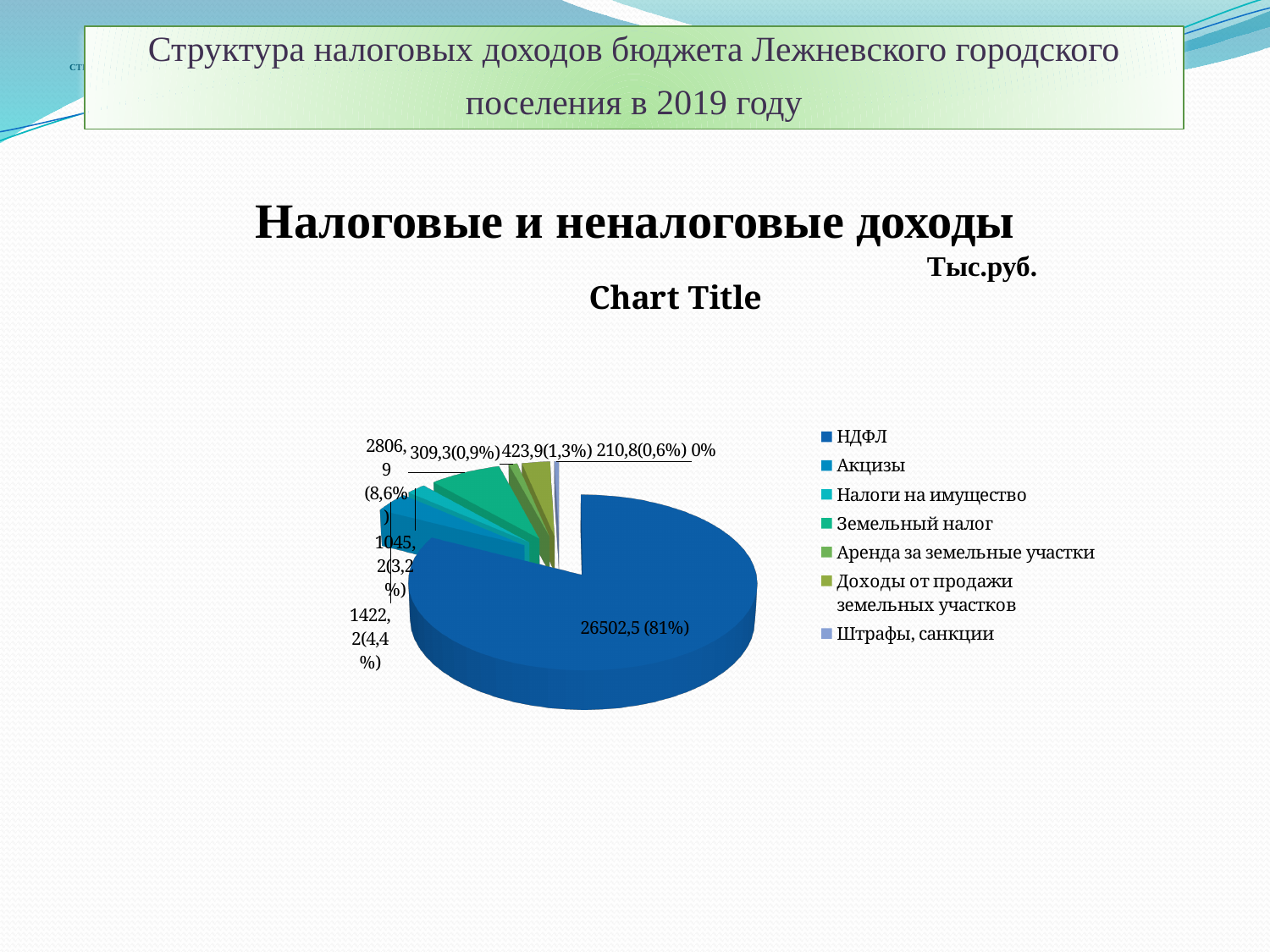
How many entries does the legend list? 7 What type of chart is shown on the slide? pie chart What value is labelled on the НДФЛ slice? 26502,5 (81%) In what units are the chart values given, according to the slide? Тыс.руб. What is the second-largest value labelled on the pie? 2806,9 (8,6%) Is the share of НДФЛ greater or less than 50%? greater What share of the pie does НДФЛ account for? 81% What title is printed directly above the pie chart? Chart Title What is the difference between the largest labelled value (26502,5) and the second-largest labelled value (2806,9)? 23695,6 Which is larger: the slice labelled 1422,2 or the slice labelled 1045,2? 1422,2 What is the smallest non-zero percentage labelled on the pie? 0,6% Which category has the largest slice of the pie? НДФЛ